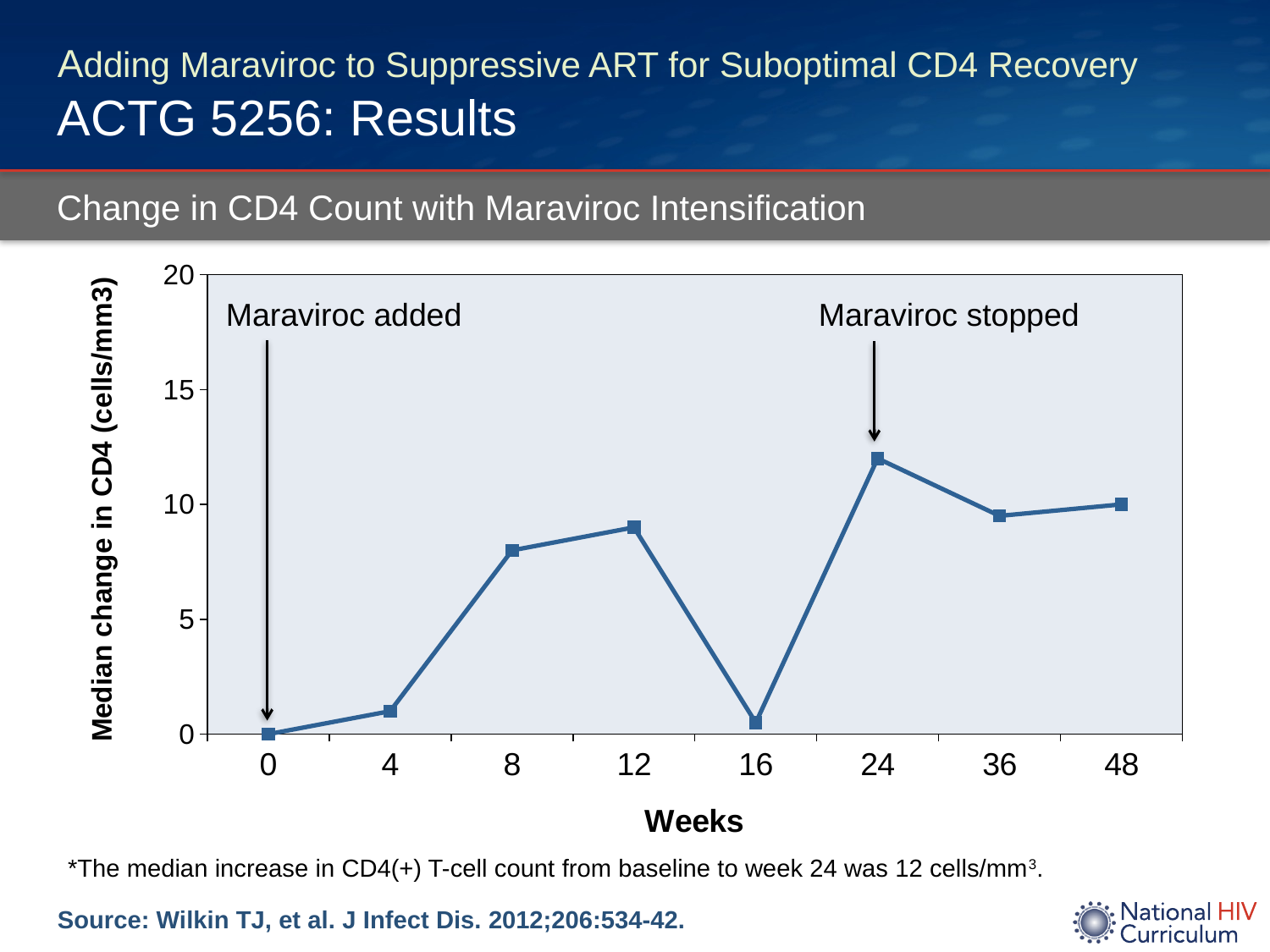
Is the value at week 16 greater or less than 5? less What annotation is shown above the data point at week 24? Maraviroc stopped How many data points are plotted on the line? 8 Is the value at week 8 greater or less than 5? greater Which has the larger median change in CD4 count, week 24 or week 36? week 24 Does the median change in CD4 count rise or fall from week 0 to week 12? rise What is the median change in CD4 count at week 24? 12 cells/mm³ What kind of chart is shown on the slide? line chart Which has the larger median change in CD4 count, week 12 or week 16? week 12 Is the value at week 12 greater or less than 10? less At which week is the median change in CD4 count highest? 24 What is the median change in CD4 count at week 48? 10